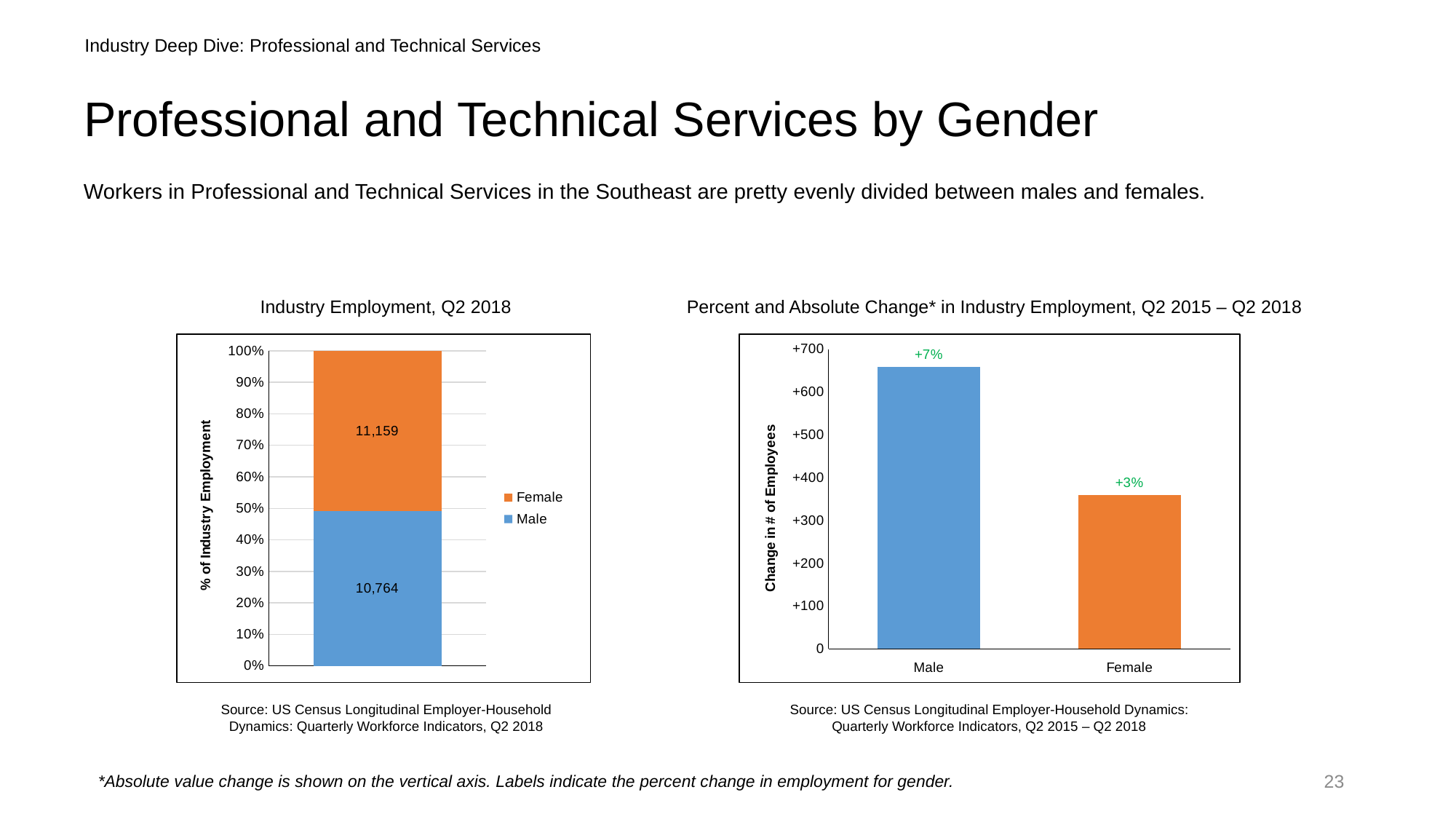
In the 'Percent and Absolute Change in Industry Employment, Q2 2015 – Q2 2018' chart, which gender has the larger change in number of employees? Male In the 'Percent and Absolute Change in Industry Employment, Q2 2015 – Q2 2018' chart, is the change in number of employees for Female greater or less than +400? less In the 'Percent and Absolute Change in Industry Employment, Q2 2015 – Q2 2018' chart, what percent change label is shown for Female? +3% In the 'Industry Employment, Q2 2018' chart, what is the data label on the Male segment? 10,764 What kind of chart is the 'Percent and Absolute Change in Industry Employment, Q2 2015 – Q2 2018' chart? Bar chart In the 'Industry Employment, Q2 2018' chart, what is the total of the stacked bar (Female plus Male)? 21,923 In the 'Industry Employment, Q2 2018' chart, what is the data label on the Female segment? 11,159 In the 'Industry Employment, Q2 2018' chart, what is the difference between the Female and Male employment counts? 395 In the 'Percent and Absolute Change in Industry Employment, Q2 2015 – Q2 2018' chart, what percent change label is shown for Male? +7% In the 'Industry Employment, Q2 2018' chart, which colour represents Female? Orange In the 'Industry Employment, Q2 2018' chart, which gender has the larger employment count? Female In the 'Industry Employment, Q2 2018' chart, how many series does the legend list? 2